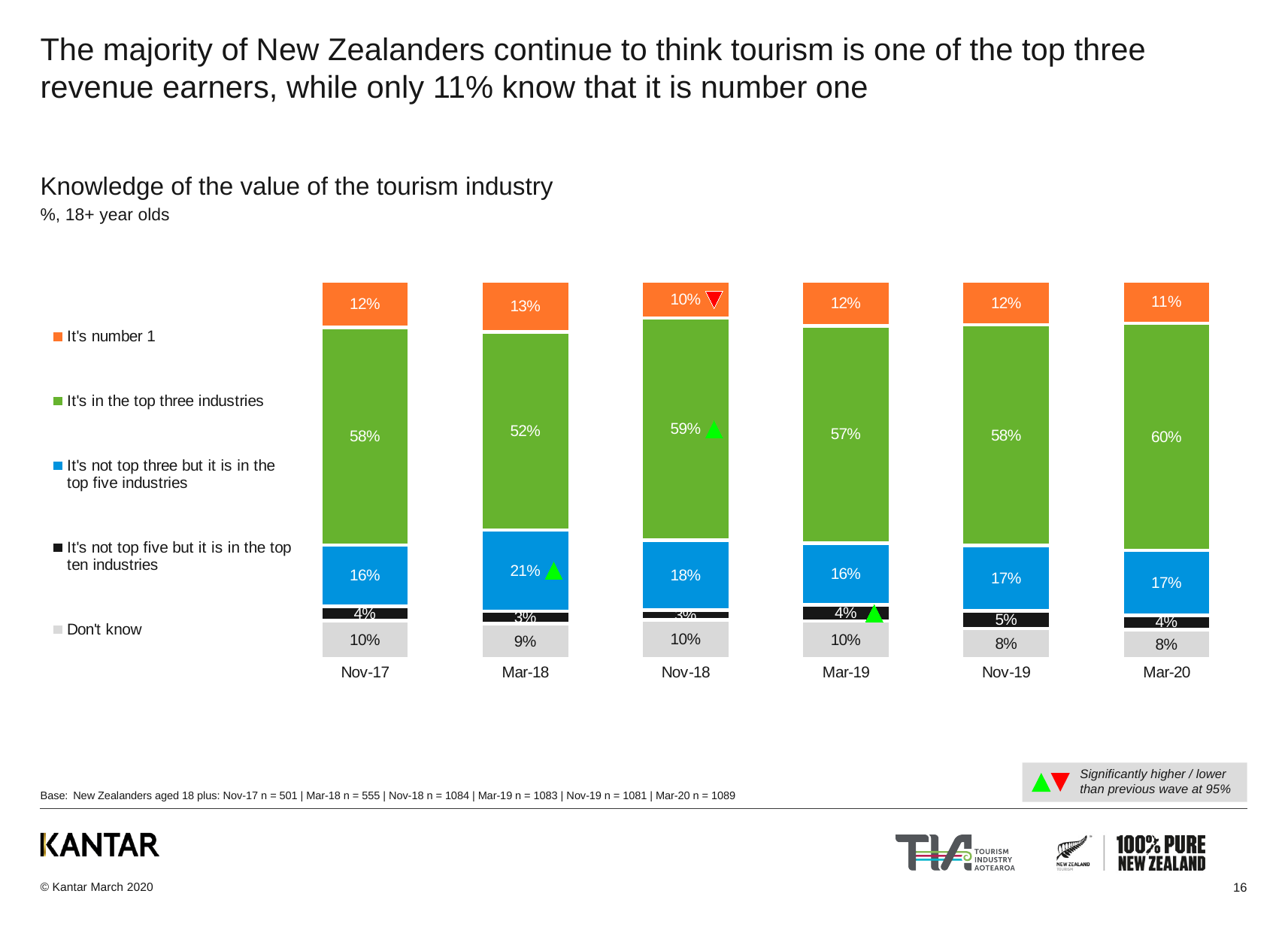
What percentage said tourism is in the top three industries in Mar-20? 60% What kind of chart is shown on the slide? stacked bar chart What is the 'Don't know' value for Nov-19? 8% How many series does the legend list? 5 How many survey waves (categories) are shown along the x axis? 6 In which wave is the 'It's in the top three industries' value lowest? Mar-18 What is the total of the stacked bar for Mar-20? 100% In which wave is the 'It's not top three but it is in the top five industries' value highest? Mar-18 What is the title of the chart? Knowledge of the value of the tourism industry Which is larger: the 'It's number 1' value for Nov-18 or for Mar-19? Mar-19 What is the difference between the 'It's in the top three industries' values for Mar-20 and Mar-18? 8% What percentage said tourism is number 1 in Mar-18? 13%